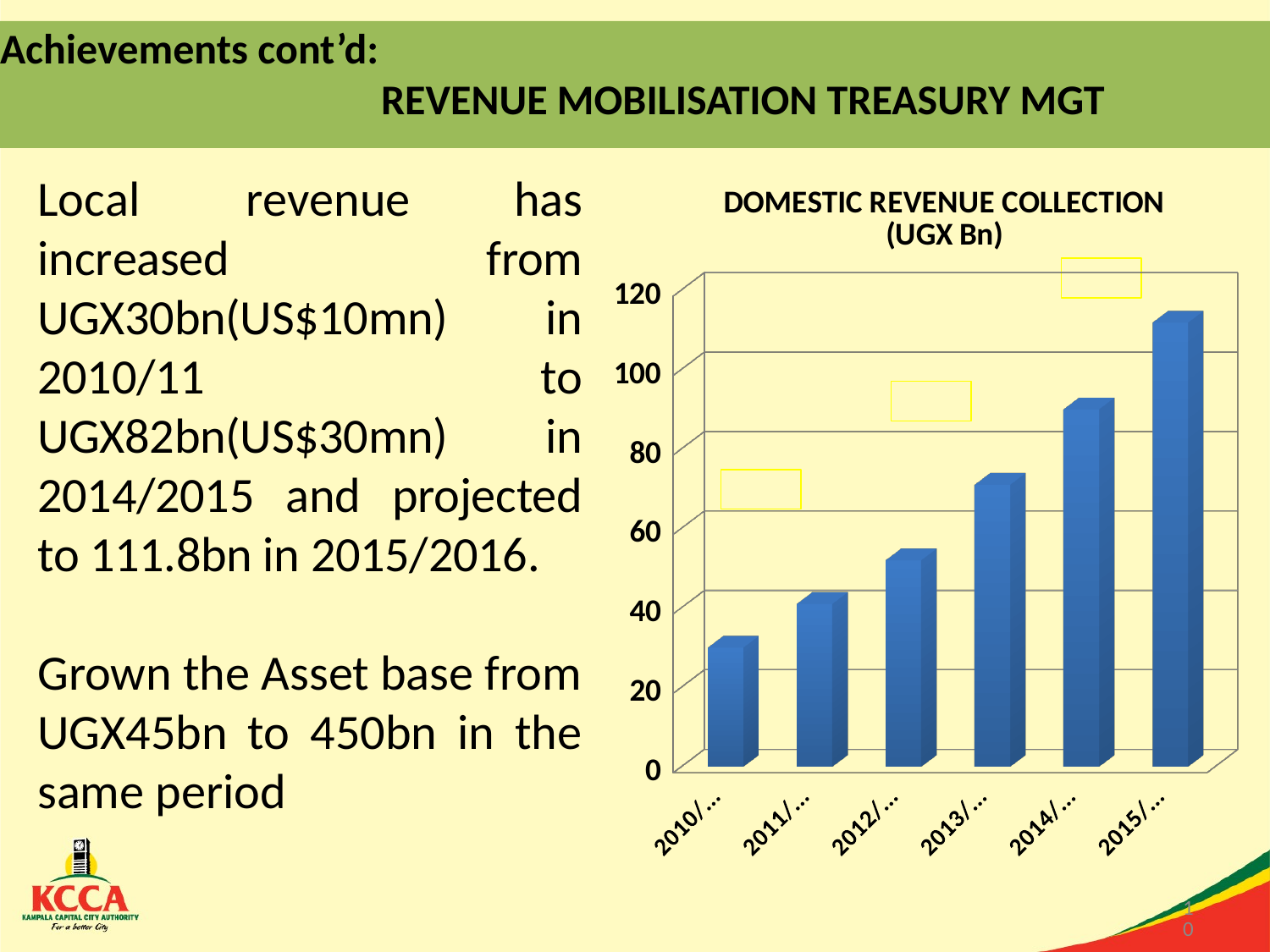
Do the values in the chart rise or fall from 2010/… to 2015/…? rise Is the value for 2010/… greater or less than 40? less Is the value for 2015/… greater or less than 100? greater Which year has the lowest domestic revenue collection in the chart? 2010/… Is the value for 2012/… greater or less than 60? less Which is larger, the value for 2013/… or the value for 2011/…? 2013/… How many bars are plotted in the chart? 6 Which year has the highest domestic revenue collection in the chart? 2015/… What kind of chart is shown on the slide? bar chart What is the title of the chart? DOMESTIC REVENUE COLLECTION (UGX Bn)